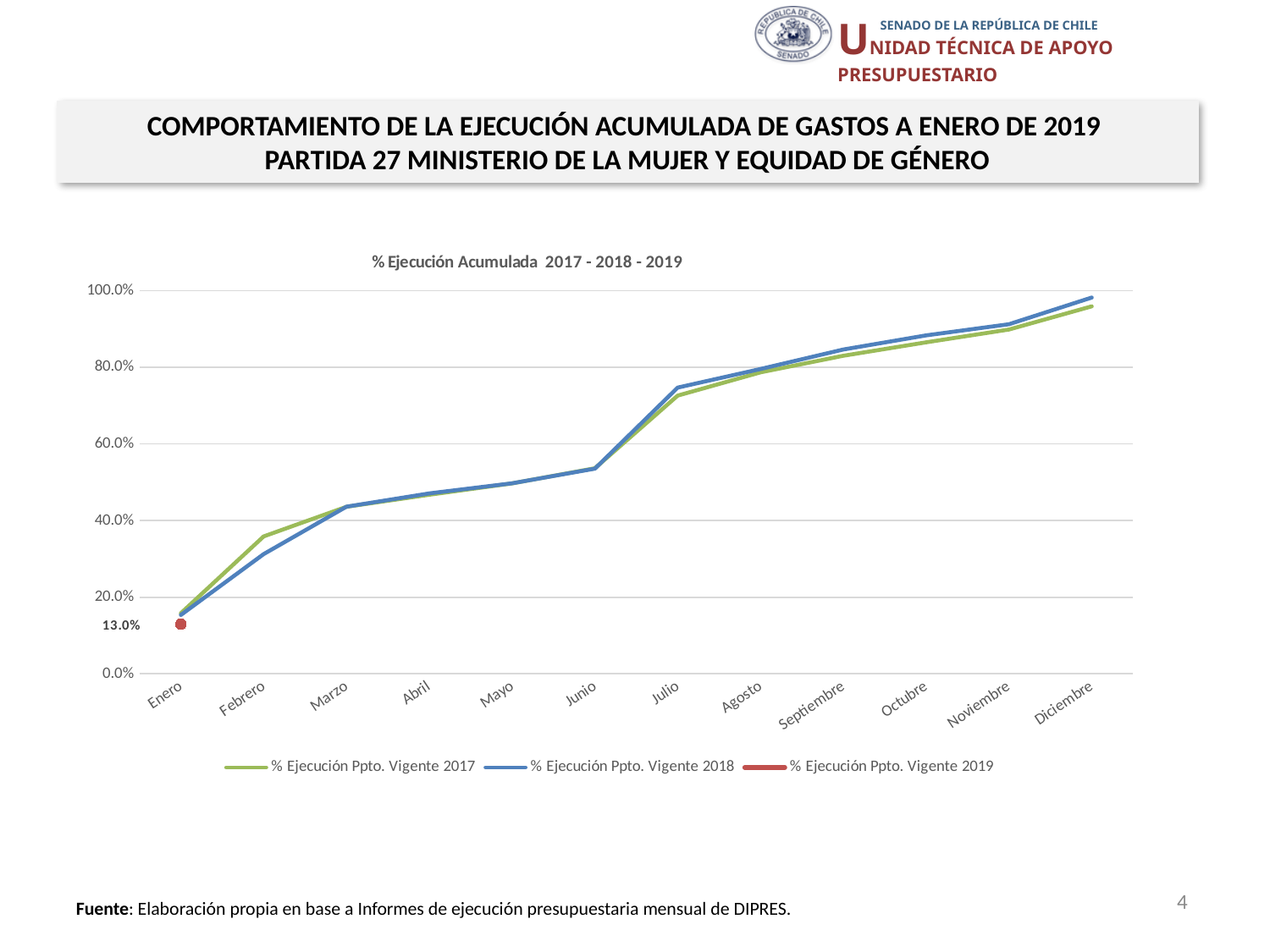
What is the title of the chart? % Ejecución Acumulada 2017 - 2018 - 2019 In which month is the value for % Ejecución Ppto. Vigente 2017 lowest? Enero Is the value for % Ejecución Ppto. Vigente 2018 in Enero greater or less than 20.0%? less What is the value for % Ejecución Ppto. Vigente 2019 in Enero? 13.0% Do the values for % Ejecución Ppto. Vigente 2018 rise or fall from Enero to Diciembre? rise In Febrero, which series has the higher value: % Ejecución Ppto. Vigente 2017 or % Ejecución Ppto. Vigente 2018? % Ejecución Ppto. Vigente 2017 How many months are shown on the x axis of the chart? 12 What kind of chart is shown on the slide? line chart In which month does % Ejecución Ppto. Vigente 2018 reach its highest value? Diciembre Is the value for % Ejecución Ppto. Vigente 2017 in Julio greater or less than 60.0%? greater Is the value for % Ejecución Ppto. Vigente 2018 in Diciembre greater or less than 80.0%? greater How many series does the chart legend list? 3